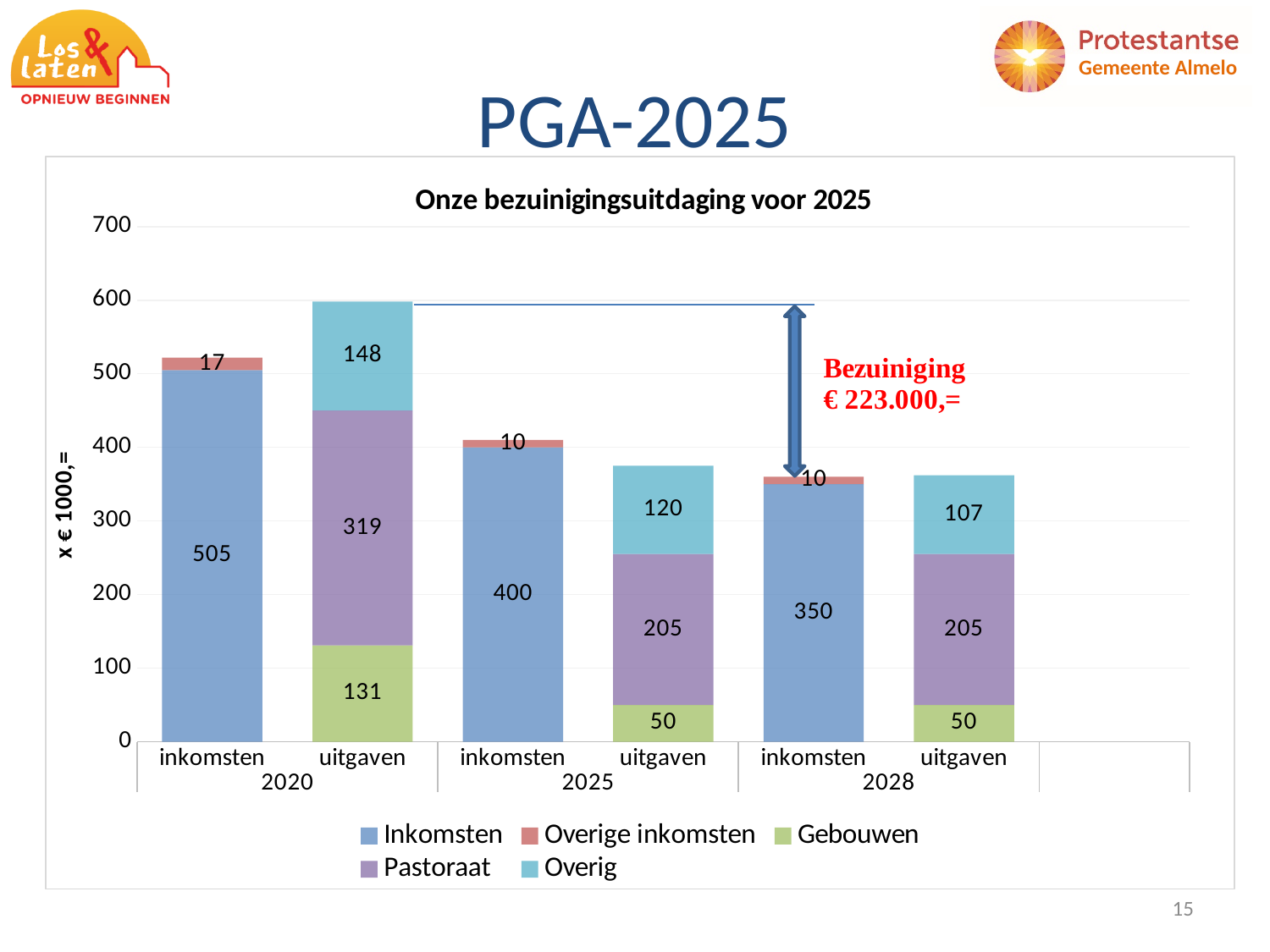
What is the total of the stacked bar for uitgaven in 2020? 598 Which bar has the highest total value? uitgaven 2020 What is the title of the chart? Onze bezuinigingsuitdaging voor 2025 What is the total of the stacked bar for inkomsten in 2025? 410 What is the value of the Pastoraat segment for uitgaven in 2020? 319 What is the value of the Gebouwen segment for uitgaven in 2025? 50 What kind of chart is shown on the slide? Stacked bar chart What is the value of the Inkomsten segment for inkomsten in 2020? 505 What is the value of the Overig segment for uitgaven in 2028? 107 Does the Inkomsten segment for inkomsten rise or fall from 2020 to 2028? Fall How many series does the legend list? 5 What is the difference between the Inkomsten segment for inkomsten in 2020 and for inkomsten in 2028? 155